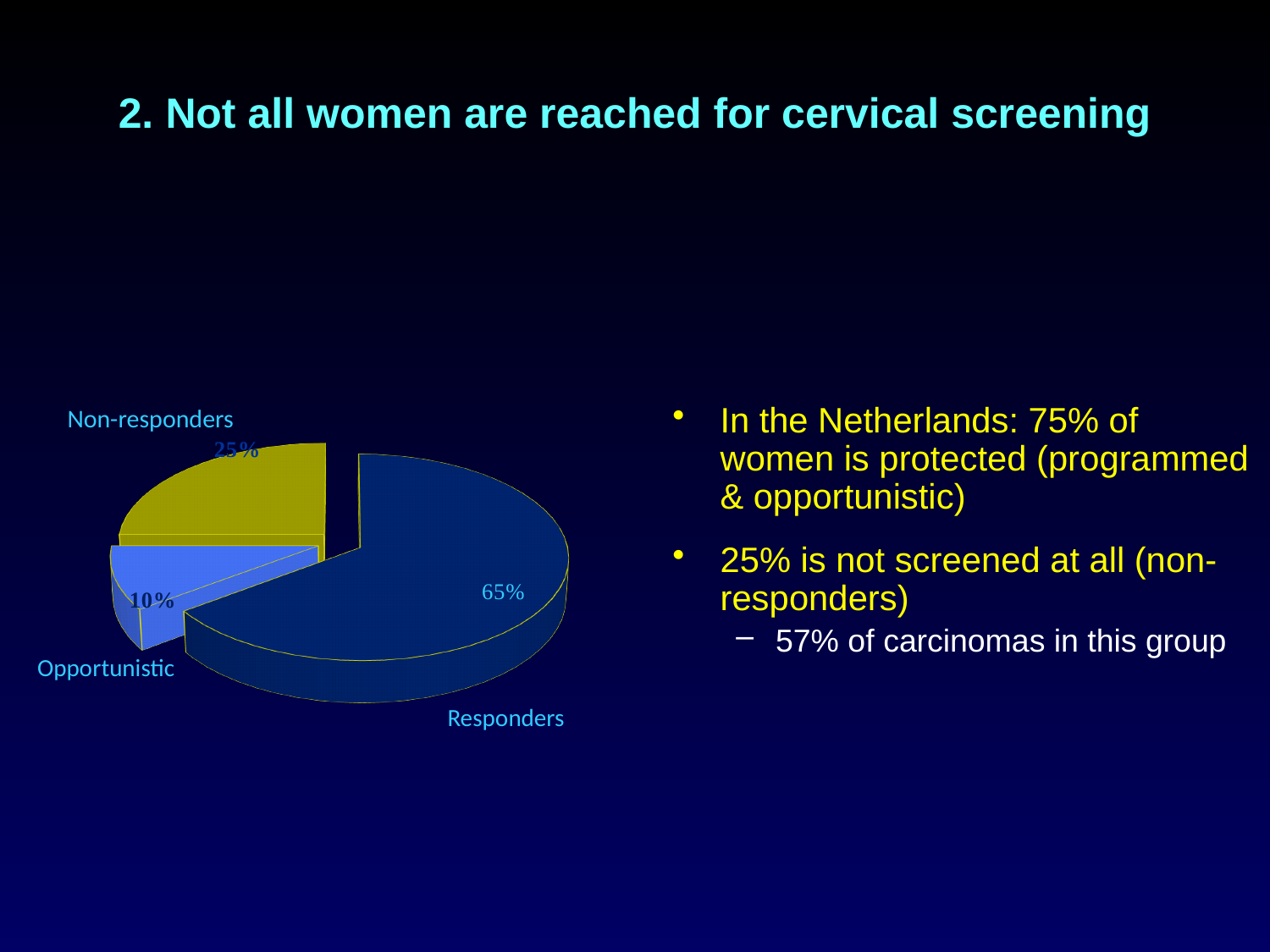
What percentage of the pie is labelled Opportunistic? 10% What kind of chart is shown on the slide? Pie chart What is the combined share of the Responders and Opportunistic slices? 75% What percentage of the pie is labelled Responders? 65% Which is larger, the Non-responders slice or the Opportunistic slice? Non-responders What colour is the Non-responders slice of the pie chart? Yellow Which slice of the pie chart is the largest? Responders What percentage of the pie is labelled Non-responders? 25% What is the difference in percentage points between the Responders slice and the Non-responders slice? 40 What is the difference in percentage points between the Non-responders slice and the Opportunistic slice? 15 How many slices does the pie chart have? 3 Which slice of the pie chart is the smallest? Opportunistic